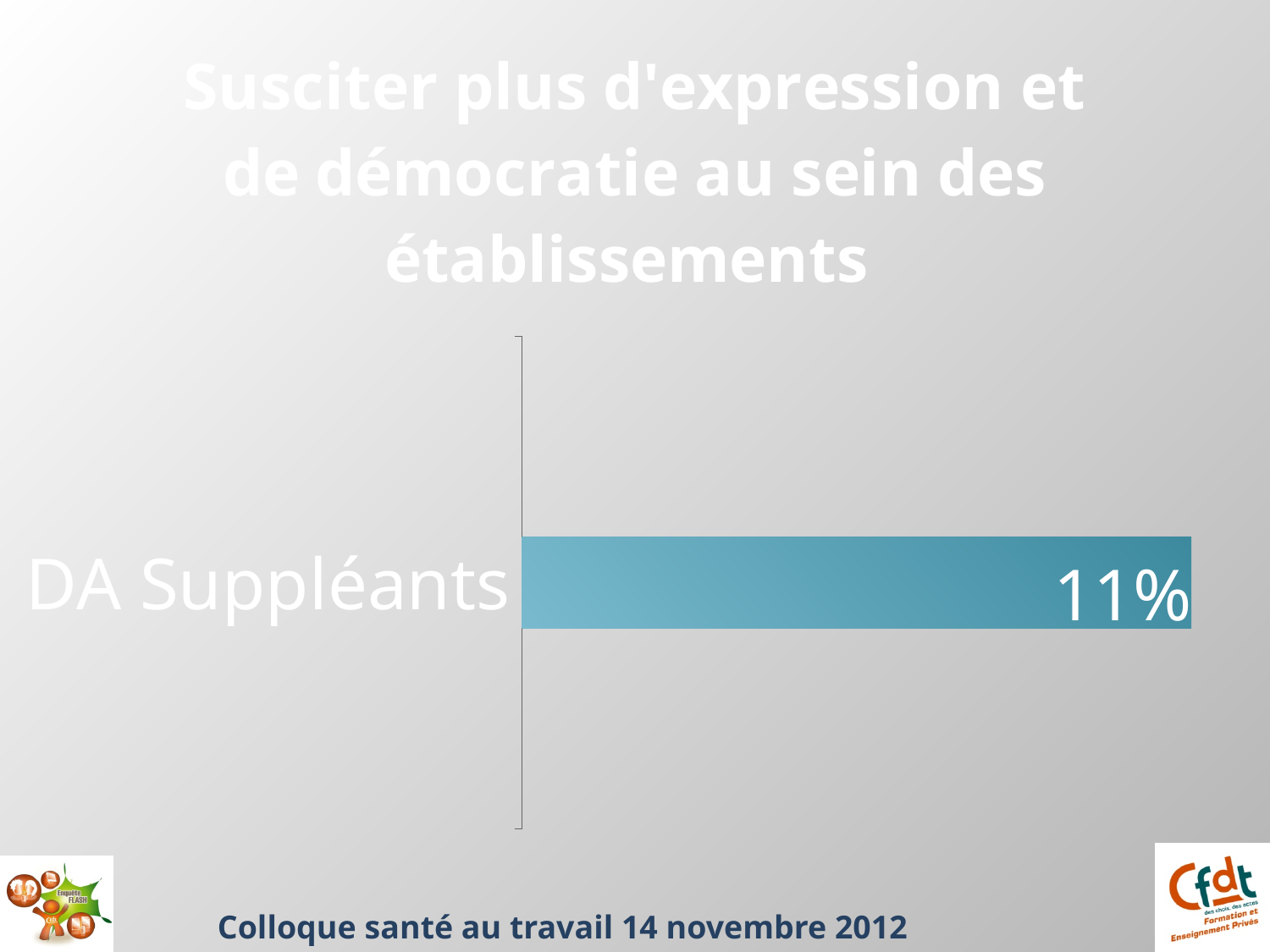
What colour is the bar for DA Suppléants? blue Is the value for DA Suppléants greater or less than 20%? less Is the value for DA Suppléants greater or less than 10%? greater How many categories does the chart show? 1 What is the label of the single category in the chart? DA Suppléants What kind of chart is shown on the slide? bar chart What is the value shown for DA Suppléants? 11%